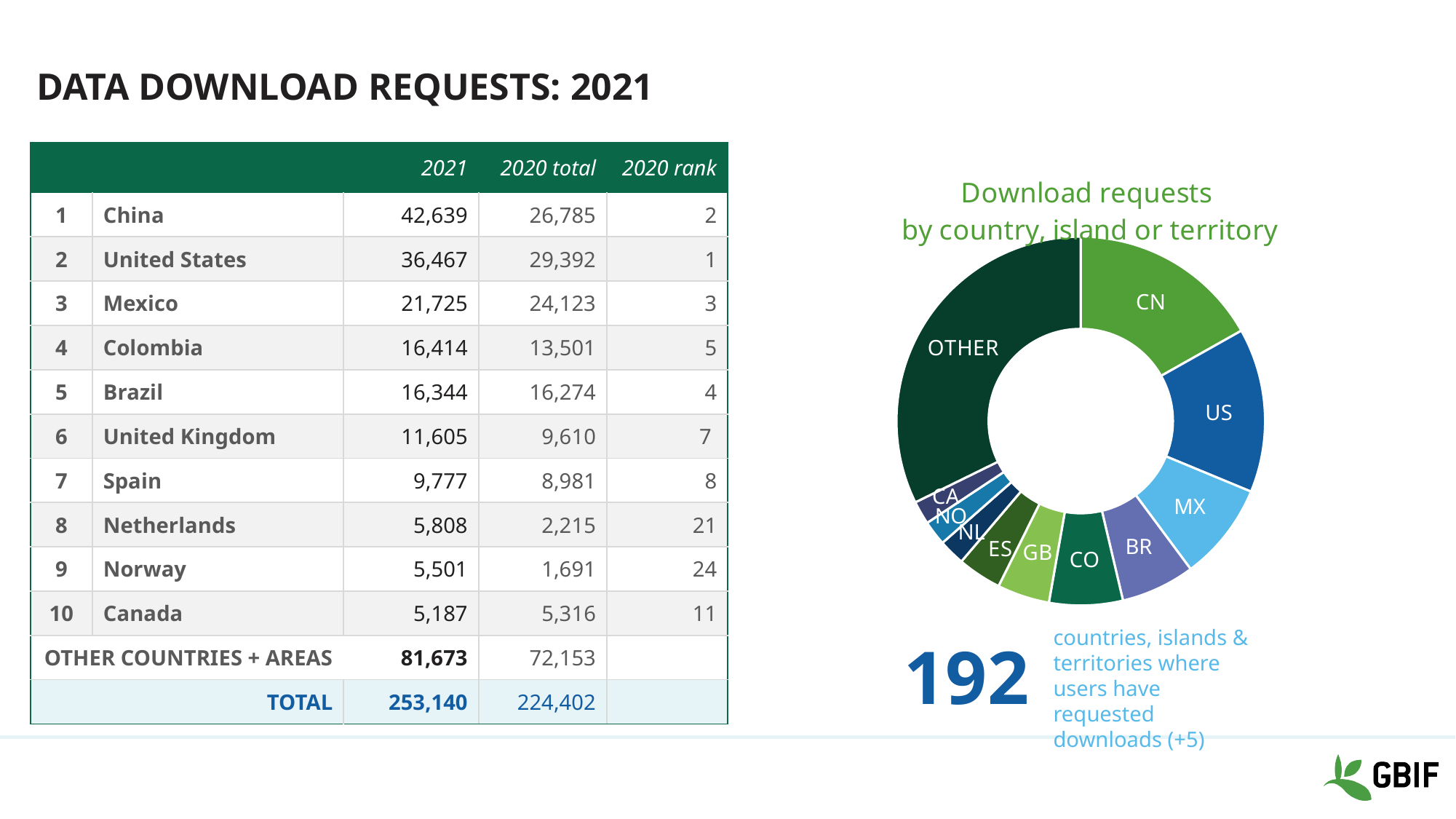
What is the total number of 2021 download requests represented by the whole donut chart? 253,140 How many slices does the donut chart have? 11 According to the slide, how many download requests in 2021 does the CN slice of the donut chart represent? 42,639 In the donut chart, which slice is larger, CN or CO? CN In the donut chart, which slice is larger, US or MX? US Which slice of the donut chart is labelled in the light blue colour? MX What kind of chart is shown on the right of the slide? Donut (pie) chart Which individual country slice in the donut chart is the largest? CN According to the slide, how many download requests in 2021 does the OTHER slice of the donut chart represent? 81,673 What is the title of the chart on the right of the slide? Download requests by country, island or territory Which slice of the donut chart is the largest? OTHER What is the difference in 2021 download requests between the CN and US slices? 6,172